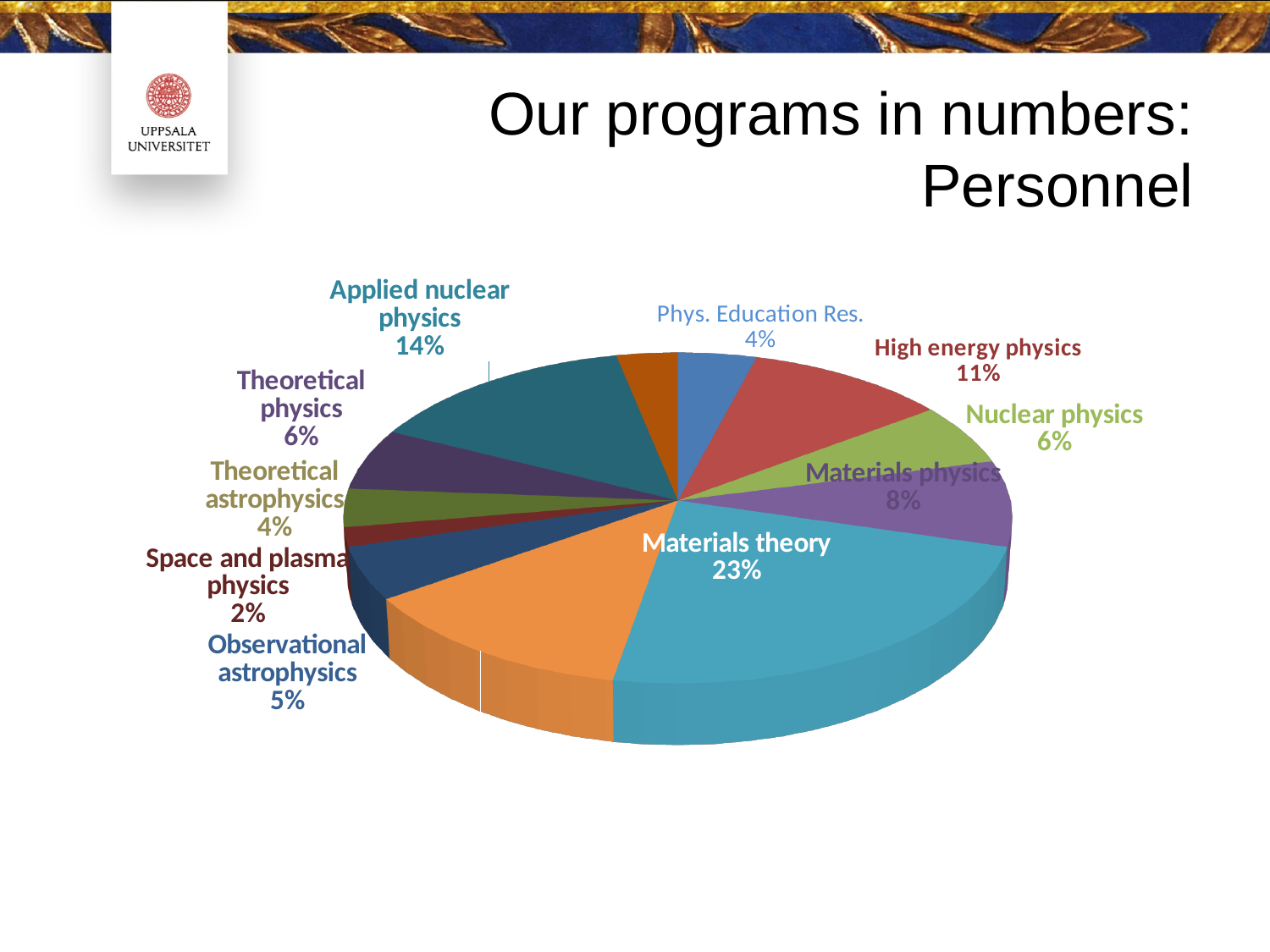
Which has a larger share: High energy physics or Materials physics? High energy physics What percentage is shown for Applied nuclear physics? 14% Which labelled program has the largest share of personnel? Materials theory What is the difference in percentage points between Materials physics and Observational astrophysics? 3 percentage points What is the title of the slide containing the chart? Our programs in numbers: Personnel What percentage is shown for High energy physics? 11% What percentage is shown for Theoretical physics? 6% Which labelled program has the smallest share of personnel? Space and plasma physics What share of personnel is in Materials theory? 23% What kind of chart is shown on the slide? pie chart What share does Phys. Education Res. have? 4% What is the difference in percentage points between Materials theory and Applied nuclear physics? 9 percentage points